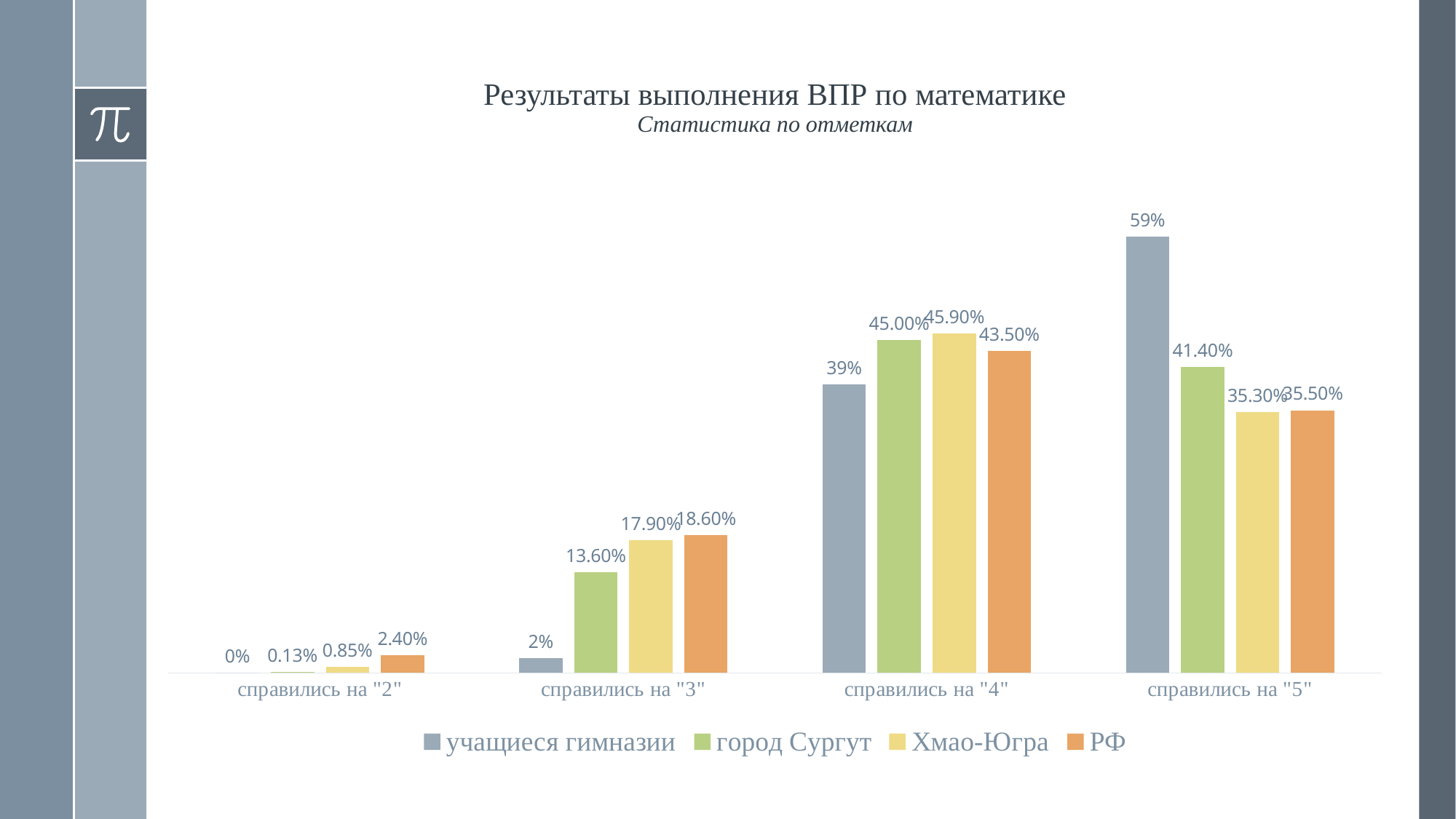
What is the value for Хмао-Югра in the category справились на "4"? 45.90% What is the subtitle of the chart? Статистика по отметкам How many series does the legend list? 4 What type of chart is shown on the slide? bar chart What is the value for РФ in the category справились на "3"? 18.60% What is the difference between учащиеся гимназии and город Сургут in the category справились на "5"? 17.60% What is the value for город Сургут in the category справились на "2"? 0.13% Which is larger in the category справились на "4": город Сургут or учащиеся гимназии? город Сургут How many categories are shown on the x axis? 4 What is the value for учащиеся гимназии in the category справились на "5"? 59% Which series has the highest value in the category справились на "5"? учащиеся гимназии Which series has the lowest value in the category справились на "3"? учащиеся гимназии